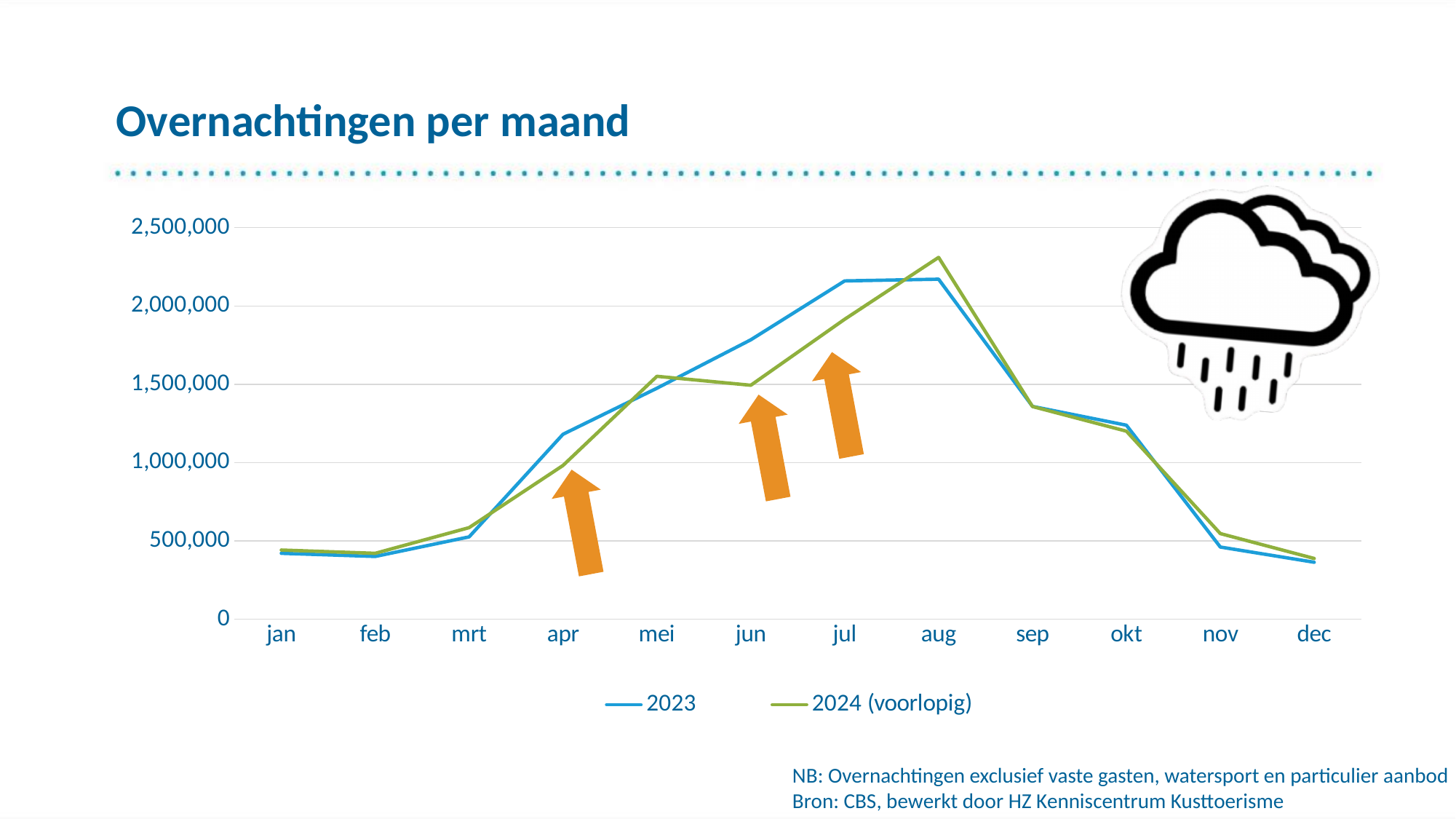
How many series does the legend list? 2 Is the value for jun in the 2024 (voorlopig) series greater or less than 2,000,000? less Is the value for nov in the 2023 series greater or less than 1,000,000? less What kind of chart is shown on the slide? line chart Which two series are listed in the legend? 2023 and 2024 (voorlopig) What is the title of the chart? Overnachtingen per maand How many months are plotted along the x axis? 12 Is the value for aug in the 2024 (voorlopig) series greater or less than 2,000,000? greater For jun, which series has the larger value, 2023 or 2024 (voorlopig)? 2023 For aug, which series has the larger value, 2023 or 2024 (voorlopig)? 2024 (voorlopig) In which month does the 2024 (voorlopig) series reach its highest value? aug